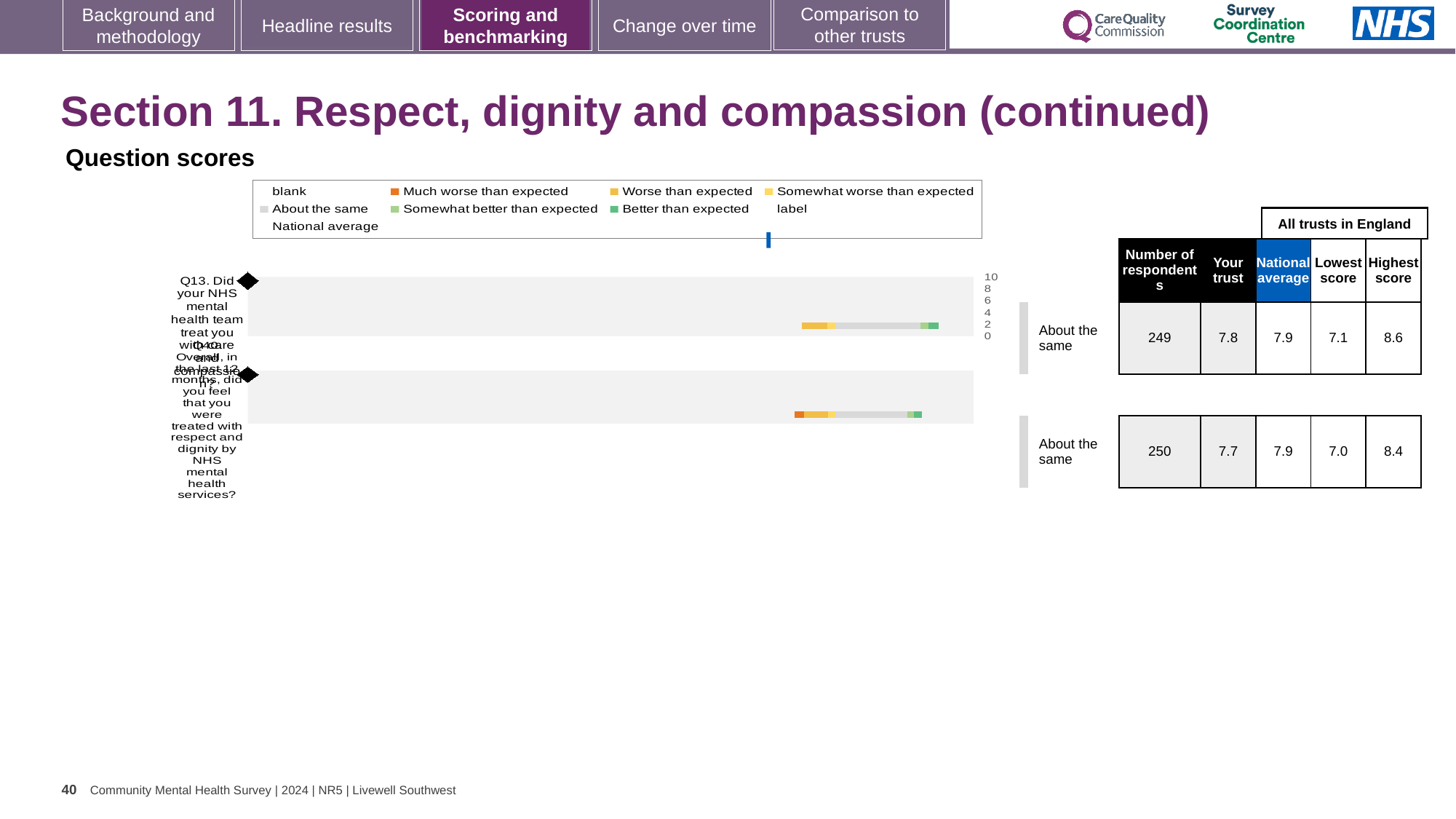
In the table, what is the lowest score for Q40? 7.0 What is the difference between the highest score and the lowest score for Q13 in the table? 1.5 What benchmark category is shown next to the chart for Q13? About the same How many questions (categories) are plotted in the chart? 2 In the table, what is the national average score for Q40? 7.9 In the table, what is the number of respondents for Q13? 249 In the table, what is the 'Your trust' score for Q40? 7.7 In the table, what is the 'Your trust' score for Q13? 7.8 Which question has the higher 'Your trust' score in the table, Q13 or Q40? Q13 What kind of chart is shown under 'Question scores'? bar chart What colour does the legend use for 'Much worse than expected'? orange In the table, what is the highest score for Q13? 8.6